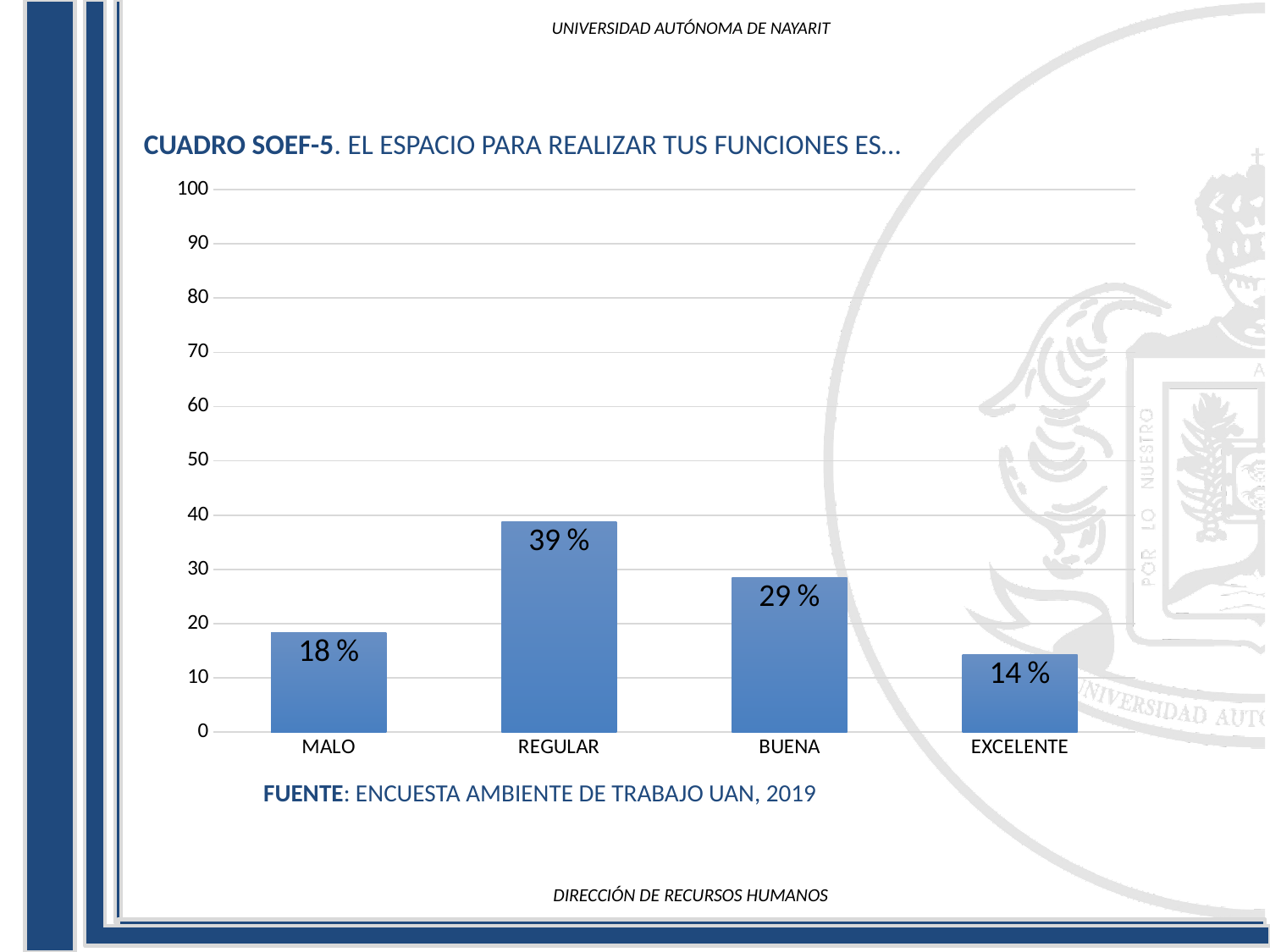
What is the value for MALO? 18 % What is the value for EXCELENTE? 14 % How many categories are shown on the x axis? 4 What kind of chart is shown on the slide? bar chart What source is cited below the chart? ENCUESTA AMBIENTE DE TRABAJO UAN, 2019 Which category has the lowest value? EXCELENTE What is the difference between the values for REGULAR and BUENA? 10 % What is the value for REGULAR? 39 % Which is larger, the value for MALO or the value for BUENA? BUENA What is the maximum value shown on the y axis? 100 Is the value for BUENA greater or less than 40? less Which category has the highest value? REGULAR